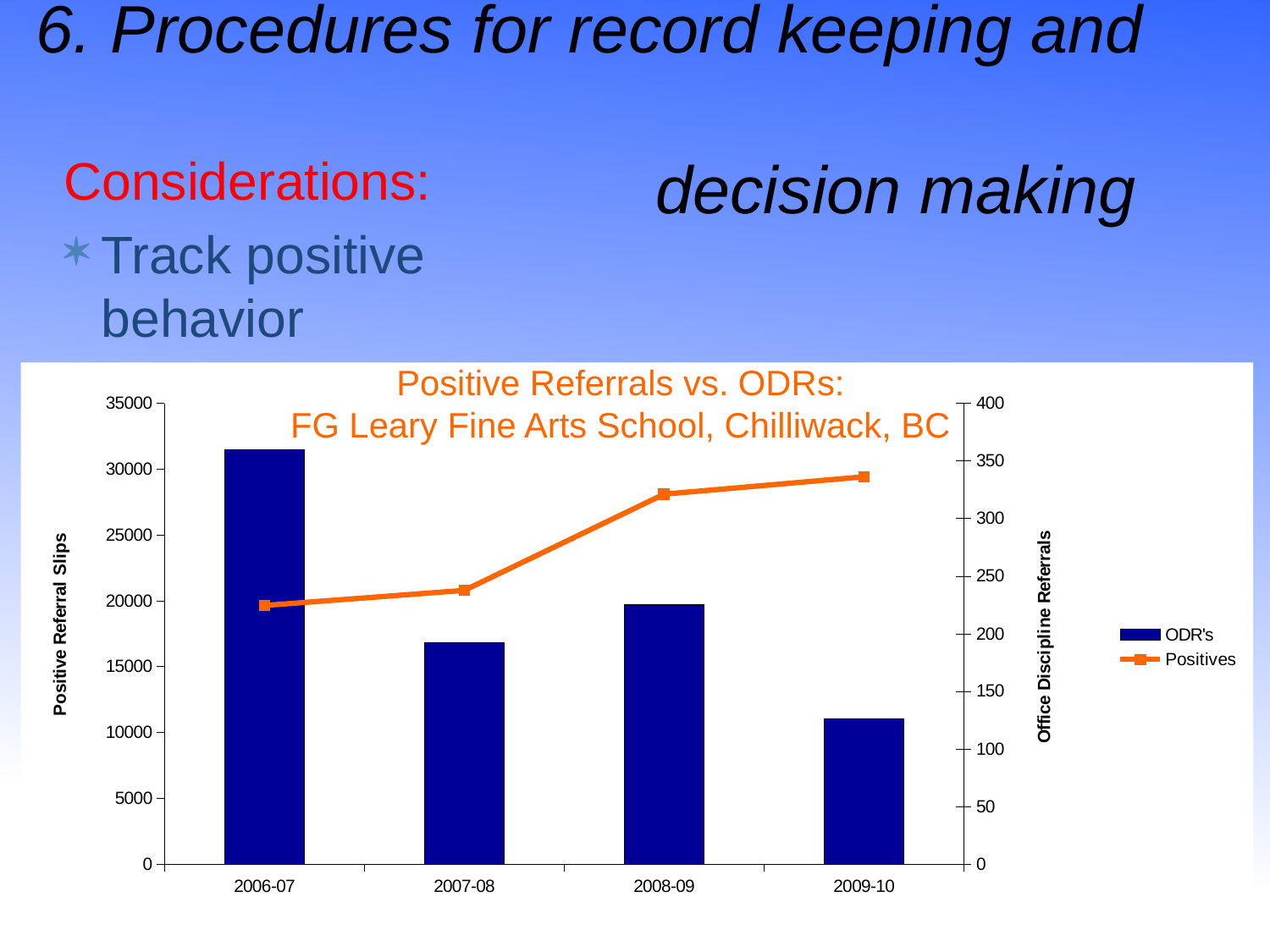
What is the label on the right-hand vertical axis of the chart? Office Discipline Referrals Does the Positives line rise or fall from 2006-07 to 2009-10? Rises Is the ODR's bar for 2006-07 greater or less than 30000 on the left axis? greater How many school years are shown on the x axis of the chart? 4 How many series does the chart's legend list? 2 Which school year has the highest ODR's bar? 2006-07 What kind of chart is shown on the slide? A combination bar and line chart Which school year has the lowest ODR's bar? 2009-10 Is the Positives value for 2008-09 greater or less than 300 on the right axis? greater Which is larger, the ODR's bar for 2007-08 or the ODR's bar for 2008-09? 2008-09 Which school year has the highest point on the Positives line? 2009-10 Is the ODR's bar for 2009-10 greater or less than 15000 on the left axis? less